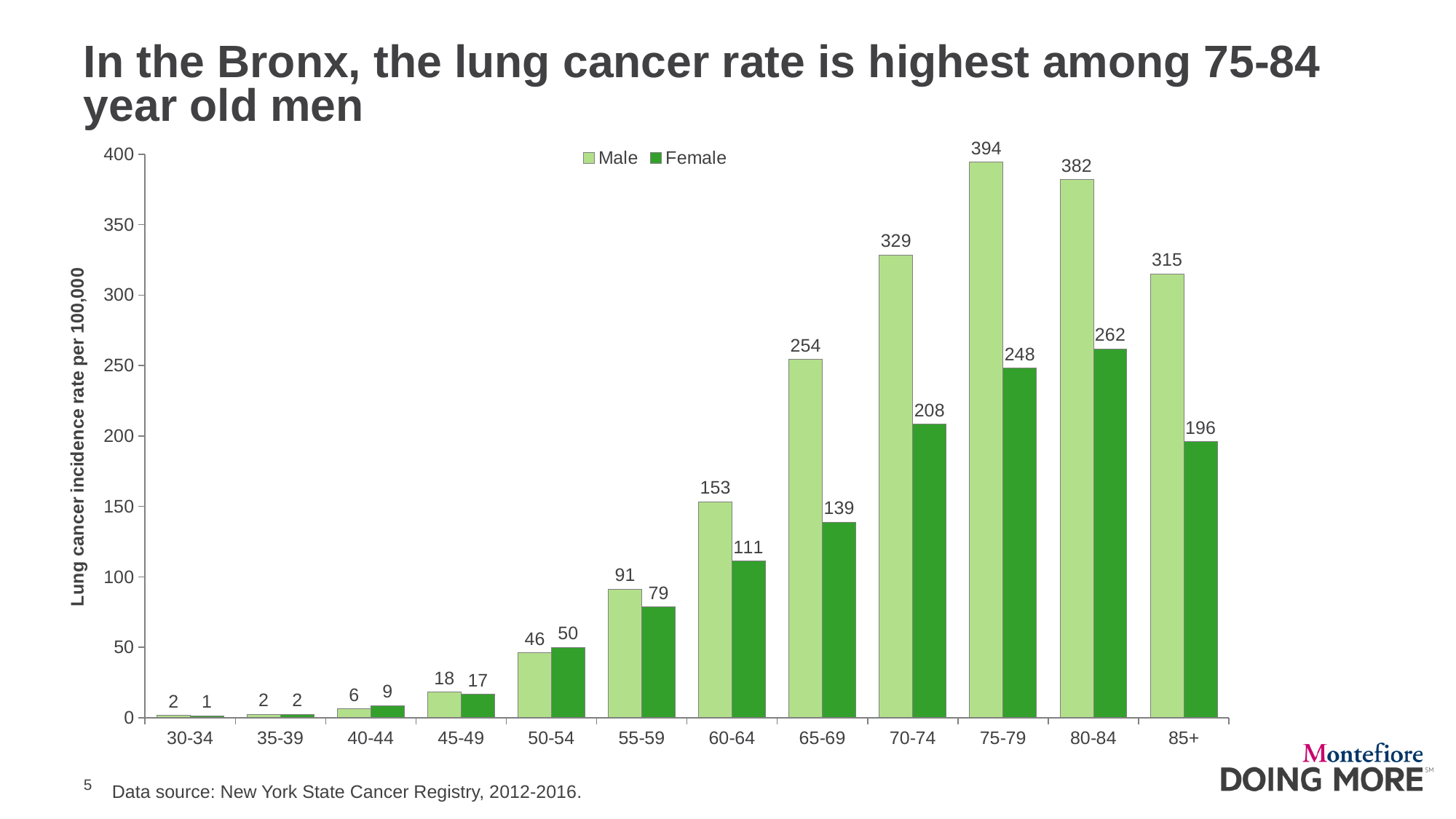
Is the male lung cancer incidence rate for the 85+ age group greater or less than 300? greater Which age group has the lowest female lung cancer incidence rate? 30-34 What is the lung cancer incidence rate for females aged 60-64? 111 For the 50-54 age group, is the male or female lung cancer incidence rate higher? Female What is the lung cancer incidence rate for males aged 75-79? 394 How many age groups are shown on the x axis? 12 What is the lung cancer incidence rate for females aged 80-84? 262 What type of chart is shown on the slide? Bar chart How many series does the legend list? 2 Which age group has the highest female lung cancer incidence rate? 80-84 What is the difference between the male and female lung cancer incidence rates for the 70-74 age group? 121 Which age group has the highest male lung cancer incidence rate? 75-79